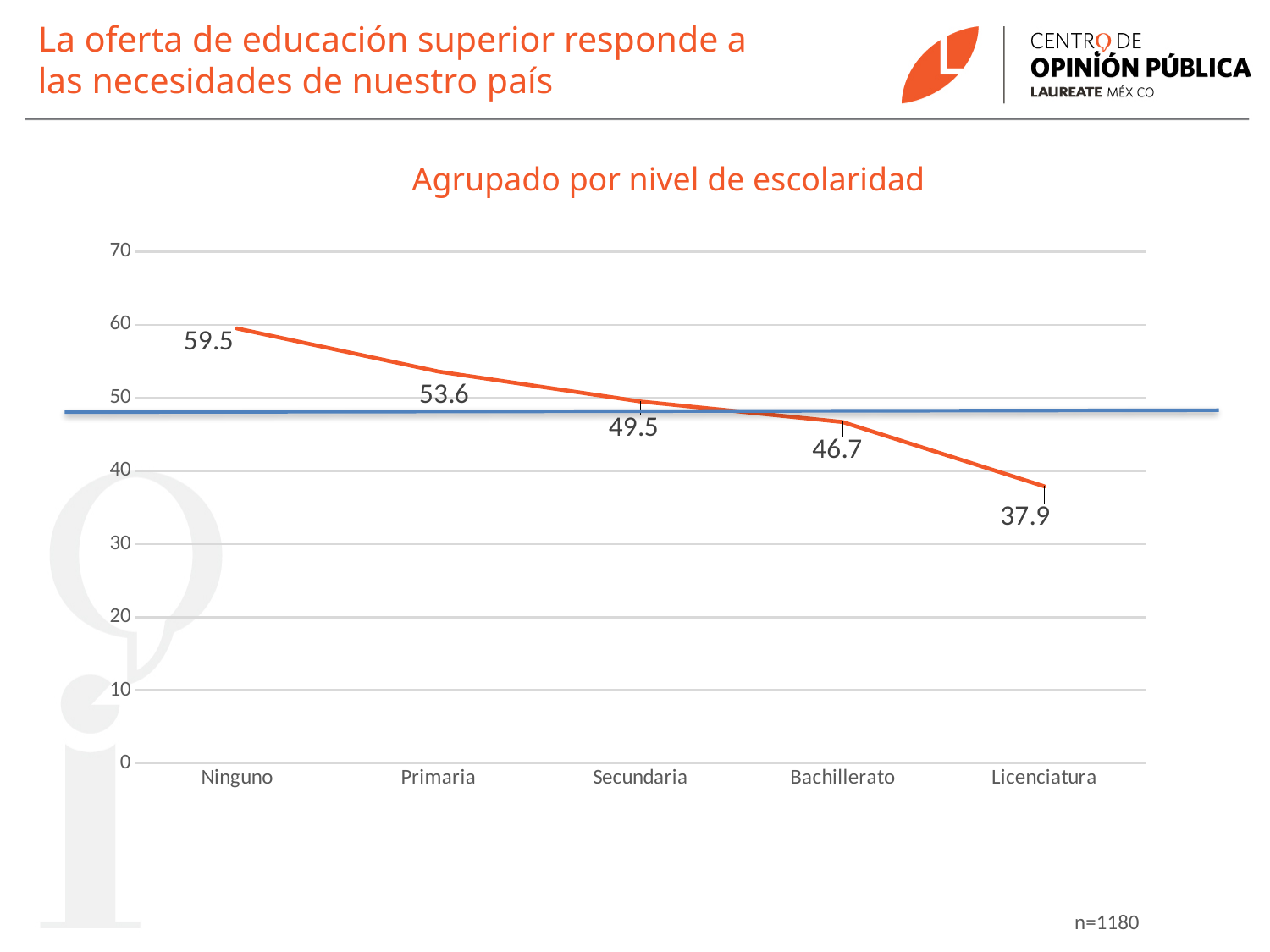
Which education level has the highest value? Ninguno What is the difference between the values for Ninguno and Licenciatura? 21.6 Do the values rise or fall from Ninguno to Licenciatura? Fall How many education levels are shown on the x axis? 5 What is the value for Bachillerato? 46.7 What is the value for Primaria? 53.6 What kind of chart is shown on the slide? Line chart Which education level has the lowest value? Licenciatura What is the value for Secundaria? 49.5 What is the value for Licenciatura? 37.9 What is the value for Ninguno? 59.5 Which is larger, the value for Primaria or the value for Bachillerato? Primaria